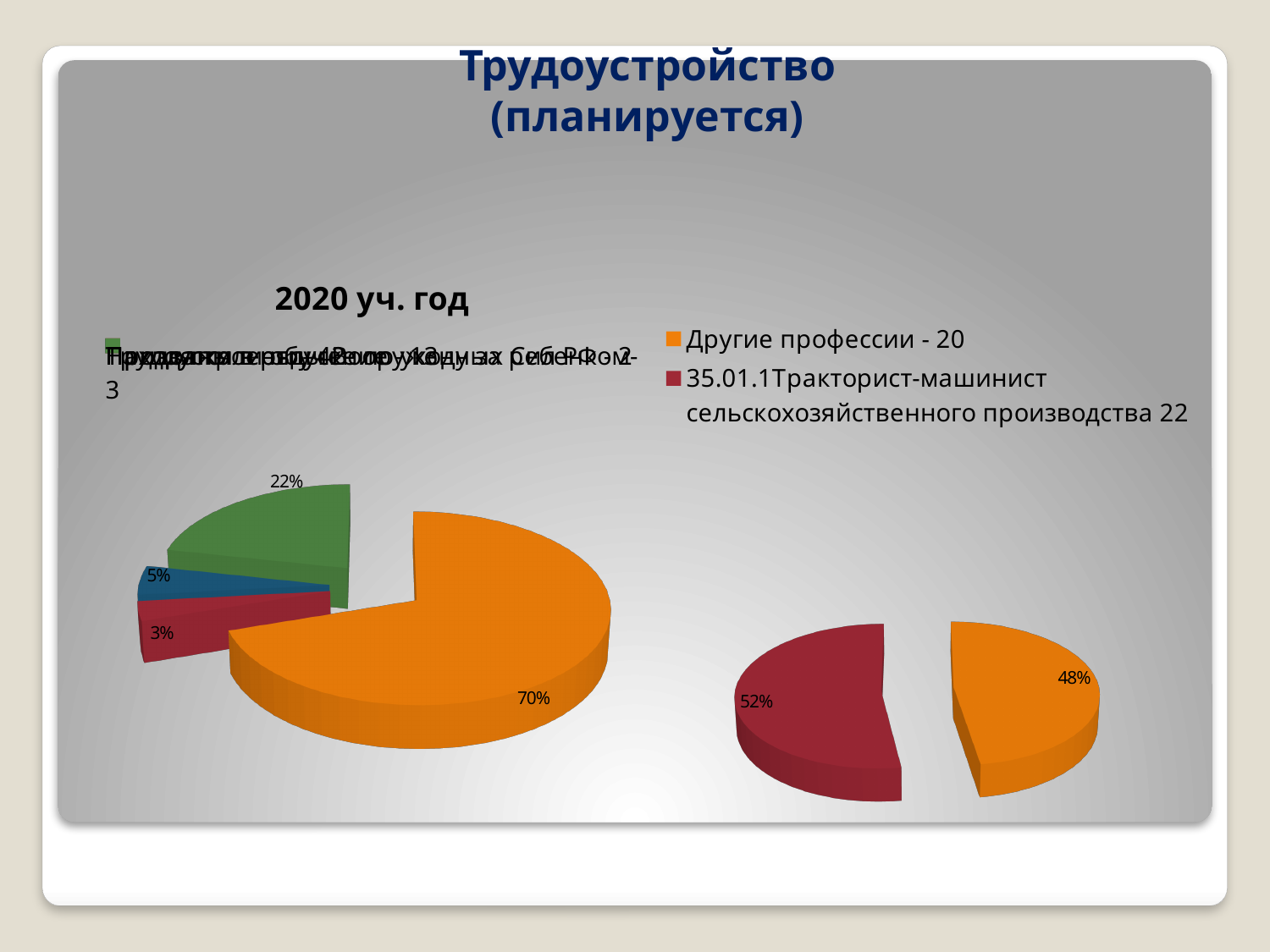
In the chart on the right side of the slide, what colour is the slice for "Другие профессии - 20"? orange In the chart titled "2020 уч. год", what is the difference between the largest slice and the green slice? 48% What kind of chart is the chart titled "2020 уч. год"? pie chart In the chart titled "2020 уч. год", what is the value of the largest slice? 70% In the chart on the right side of the slide, what is the share for "Другие профессии - 20"? 48% In the chart on the right side of the slide, what is the share for "35.01.1Тракторист-машинист сельскохозяйственного производства 22"? 52% How many entries does the legend of the chart on the right side of the slide list? 2 How many slices does the chart titled "2020 уч. год" have? 4 In the chart titled "2020 уч. год", what is the value of the smallest slice? 3% What kind of chart is the chart on the right side of the slide? pie chart In the chart on the right side of the slide, which slice is larger: "Другие профессии - 20" or "35.01.1Тракторист-машинист сельскохозяйственного производства 22"? 35.01.1Тракторист-машинист сельскохозяйственного производства 22 In the chart titled "2020 уч. год", what is the value of the green slice? 22%